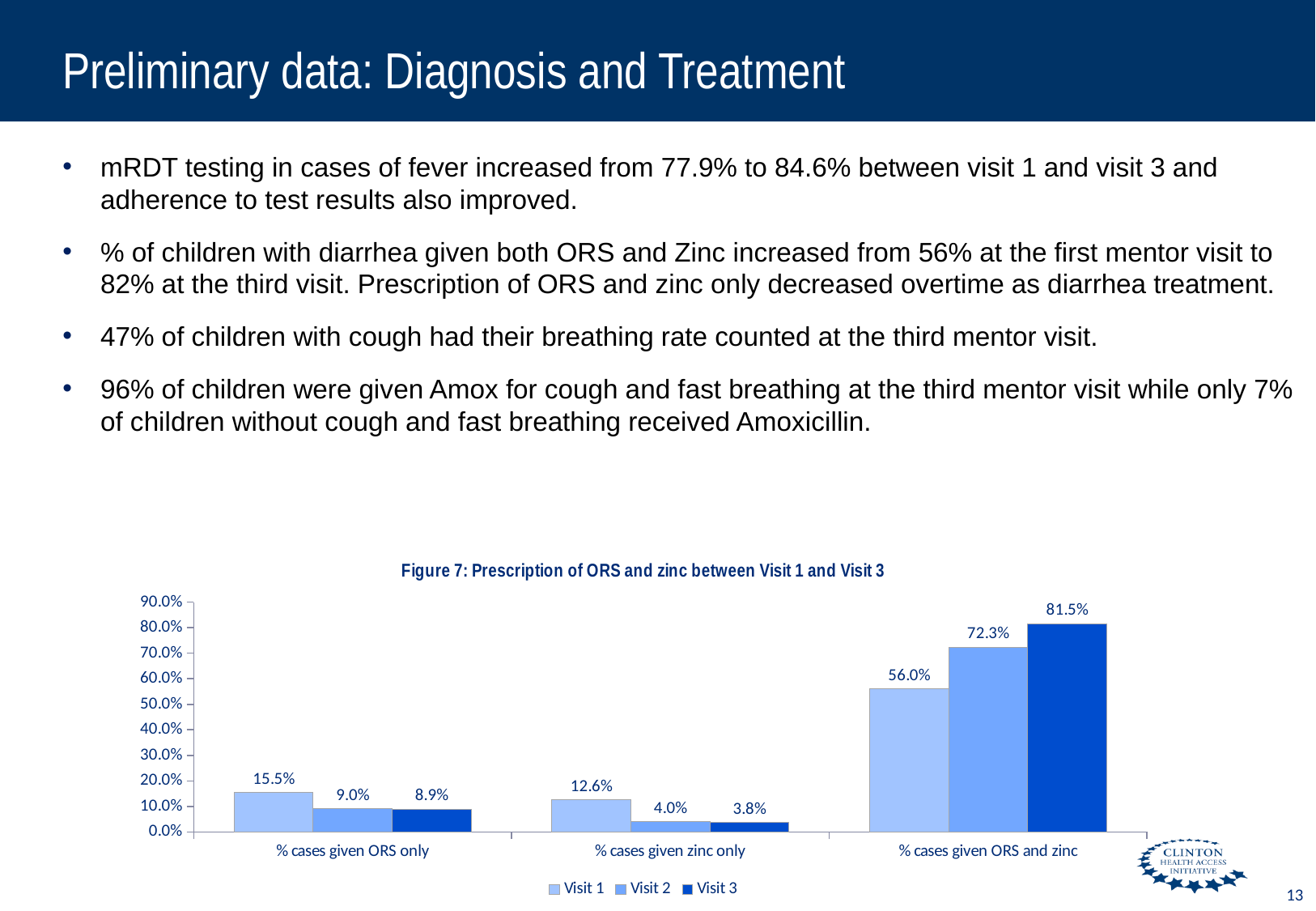
What is the value for Visit 1 in the '% cases given ORS only' category? 15.5% What is the title of the chart? Figure 7: Prescription of ORS and zinc between Visit 1 and Visit 3 What is the value for Visit 3 in the '% cases given ORS and zinc' category? 81.5% Do the values for '% cases given ORS and zinc' rise or fall from Visit 1 to Visit 3? Rise How many categories are shown on the x axis? 3 What is the difference between the Visit 3 and Visit 1 values for '% cases given ORS and zinc'? 25.5% How many series does the legend list? 3 Which category has the lowest Visit 1 value? % cases given zinc only Which is larger: the Visit 1 value for '% cases given ORS only' or the Visit 1 value for '% cases given zinc only'? % cases given ORS only What kind of chart is shown on the slide? Bar chart Which category has the highest Visit 3 value? % cases given ORS and zinc What is the value for Visit 2 in the '% cases given zinc only' category? 4.0%